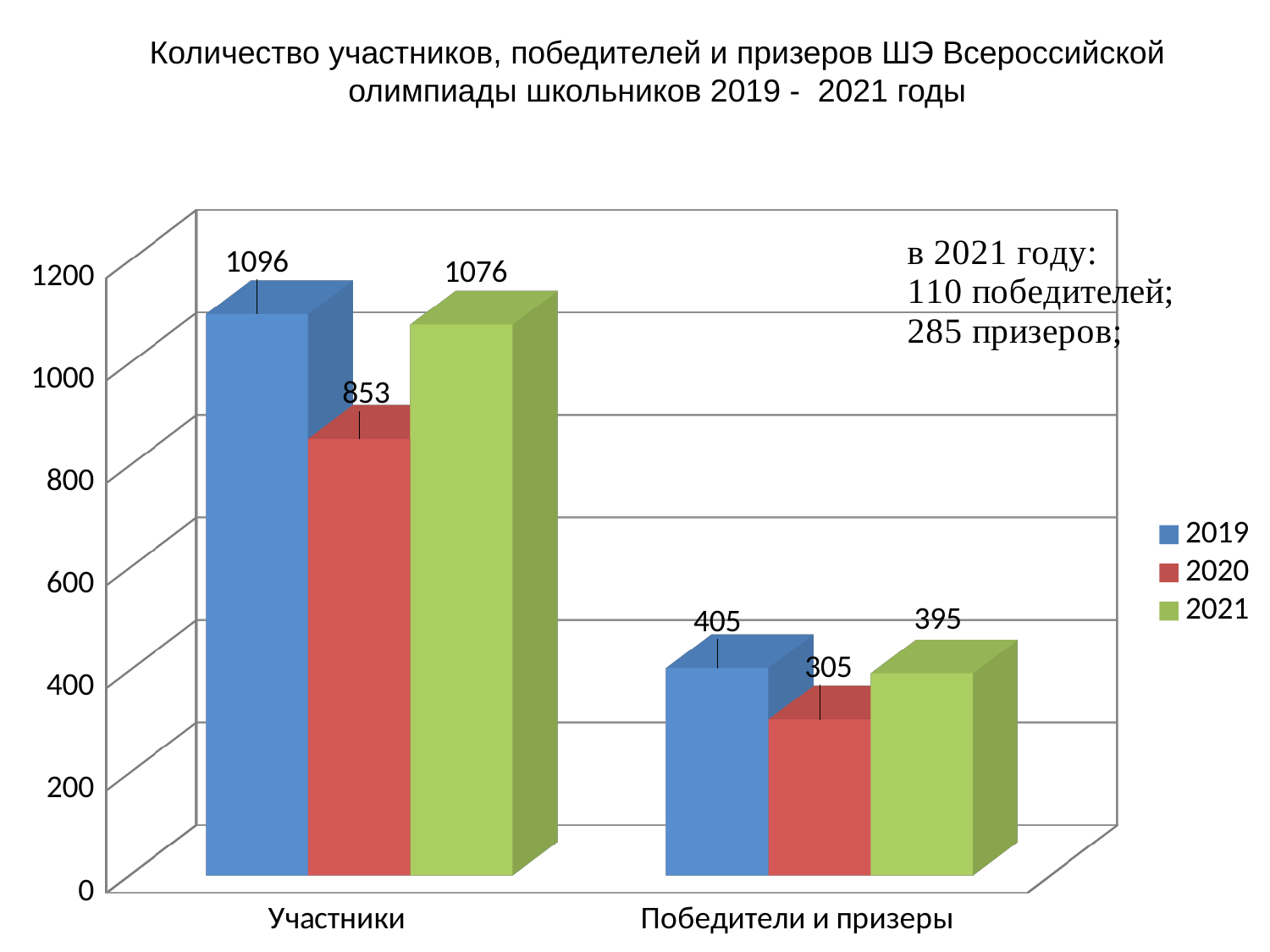
What is the value for 2019 in the Участники category? 1096 How many categories are shown on the x axis? 2 What kind of chart is shown on the slide? bar chart How many series does the legend list? 3 Which colour represents the 2020 series in the legend? red What is the difference between the 2019 and 2021 values in the Победители и призеры category? 10 Which is larger: the 2021 value for Участники or the 2020 value for Участники? 2021 What is the difference between the 2019 and 2020 values in the Участники category? 243 What is the value for 2021 in the Участники category? 1076 What is the value for 2020 in the Победители и призеры category? 305 Which year has the highest value in the Победители и призеры category? 2019 Which year has the lowest value in the Участники category? 2020